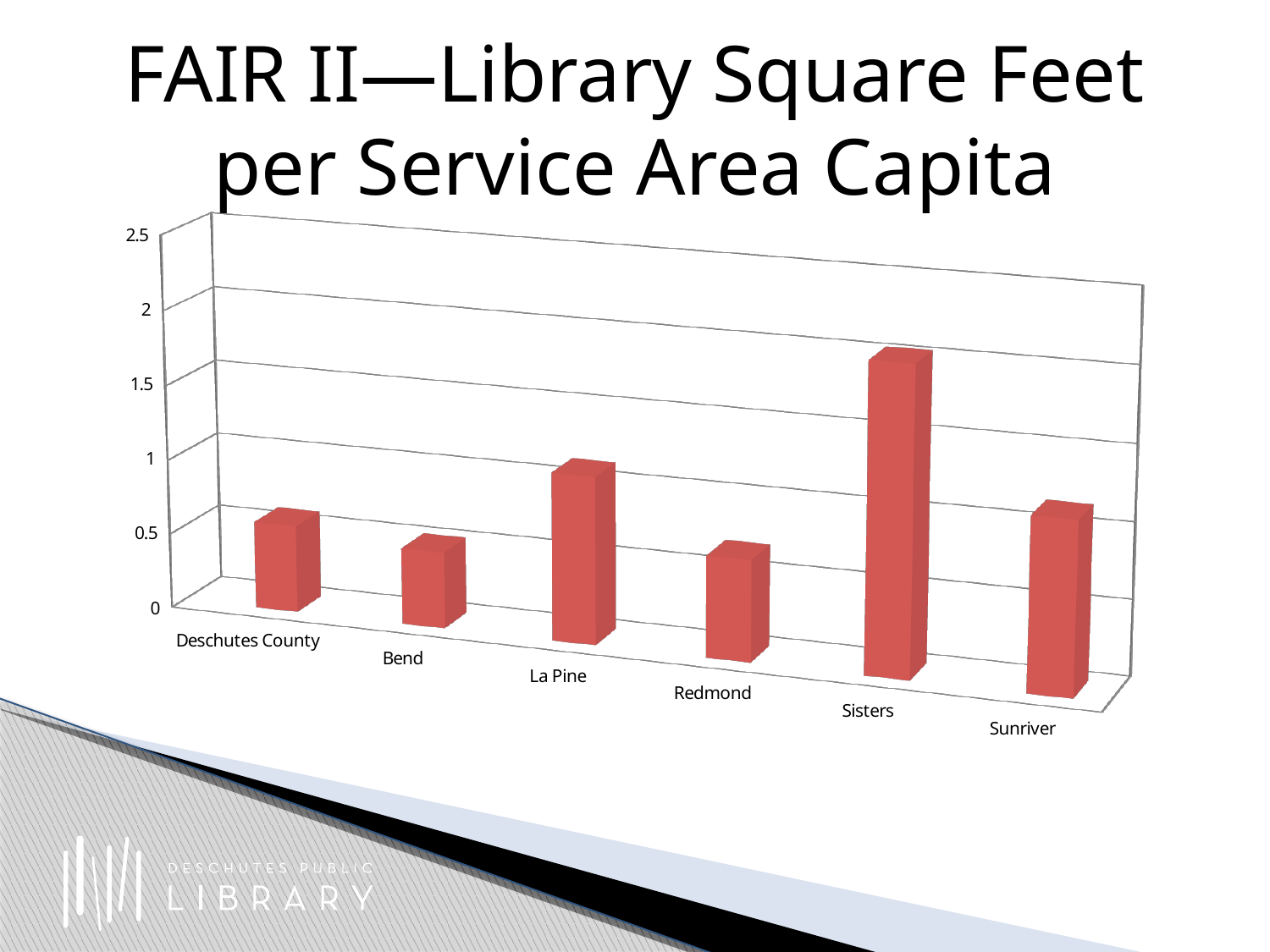
How many categories are plotted on the chart? 6 Is the value for Bend greater or less than 1? less What is the highest value shown on the vertical axis? 2.5 Which is larger, the value for Sisters or the value for Bend? Sisters Which is larger, the value for Sunriver or the value for Bend? Sunriver What is the title of the slide containing the chart? FAIR II—Library Square Feet per Service Area Capita What kind of chart is shown on the slide? bar chart Which category has the highest library square feet per service area capita? Sisters Is the value for Sisters greater or less than 1? greater Is the value for Deschutes County greater or less than 1.5? less Which is larger, the value for La Pine or the value for Redmond? La Pine